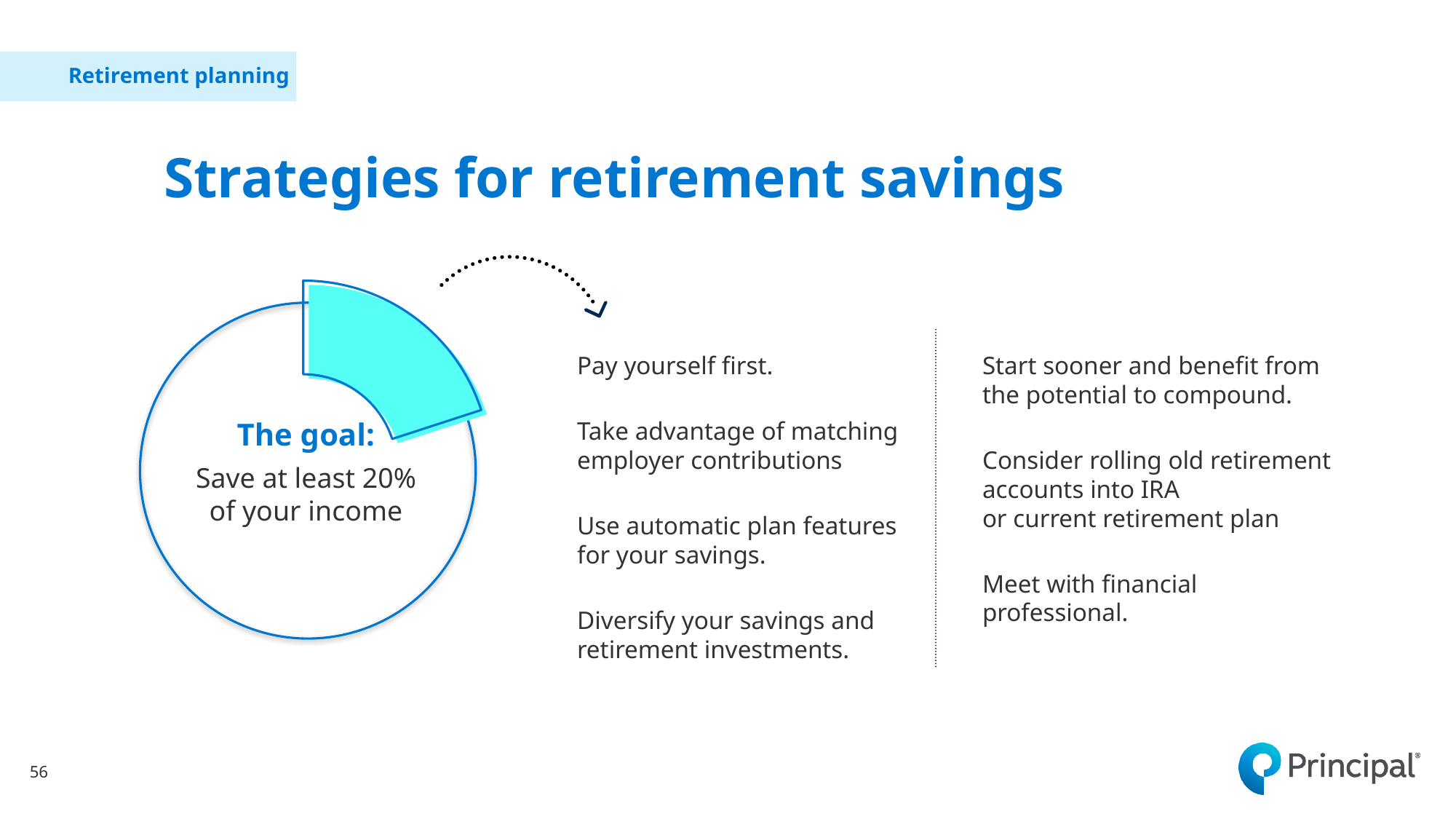
What kind of chart is shown on the left of the slide? Doughnut chart What share of income does the highlighted slice of the pie chart represent? 20% What colour is the highlighted slice of the pie chart? Cyan Is the highlighted slice of the pie chart greater or less than 50% of the circle? less What is the title of the slide containing the pie chart? Strategies for retirement savings What is the goal stated inside the pie chart? Save at least 20% of your income How many slices of the pie chart are highlighted? 1